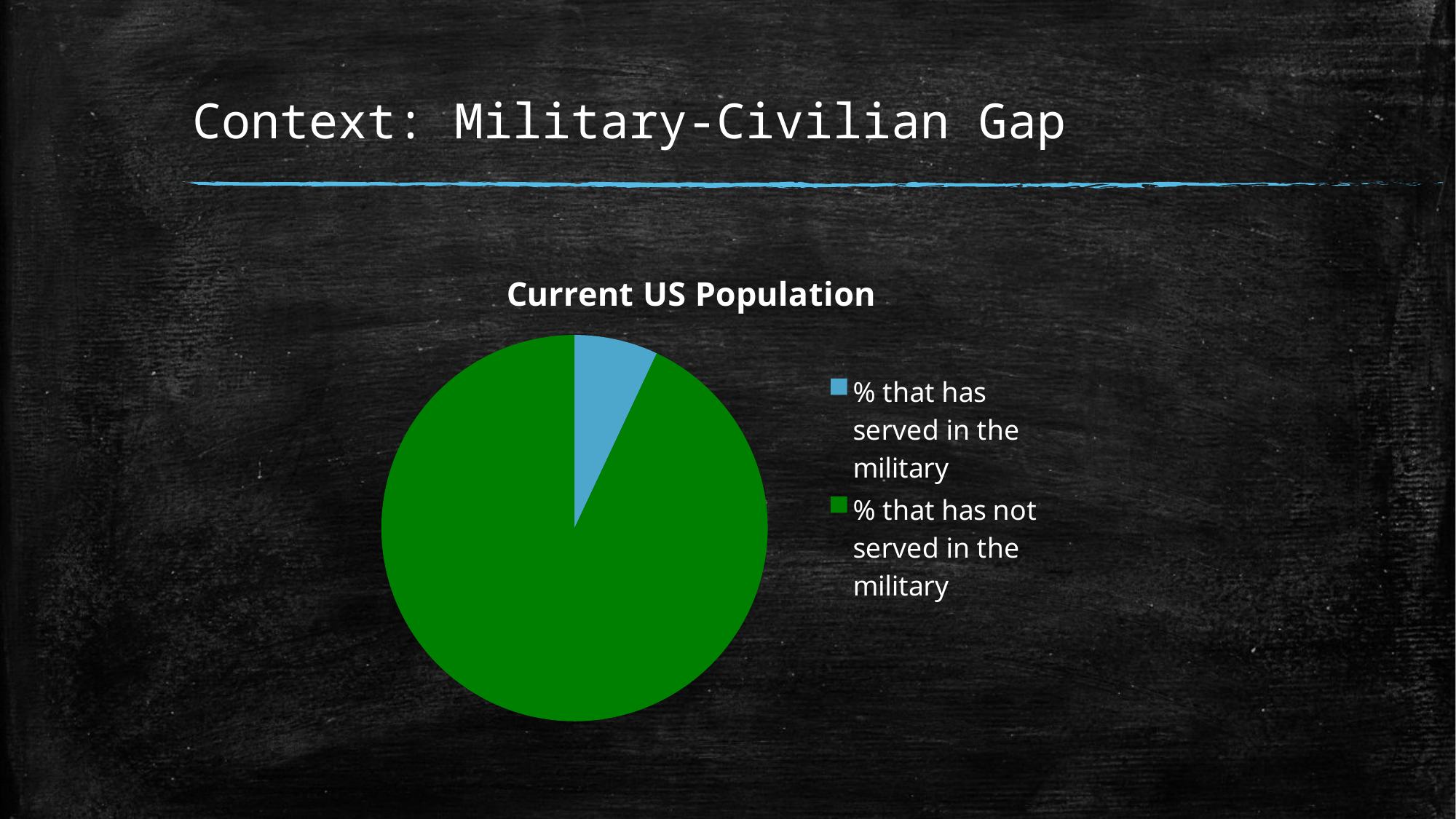
How many slices does the pie chart have? 2 What kind of chart is shown on the slide? pie chart Which slice is the largest? % that has not served in the military Is the share for % that has served in the military greater or less than 25%? less Which slice is the smallest? % that has served in the military Is the share for % that has not served in the military greater or less than 50%? greater What colour is the slice for % that has served in the military? blue How many entries does the legend list? 2 Which is larger: the slice for % that has served in the military or the slice for % that has not served in the military? % that has not served in the military What is the title of the chart? Current US Population